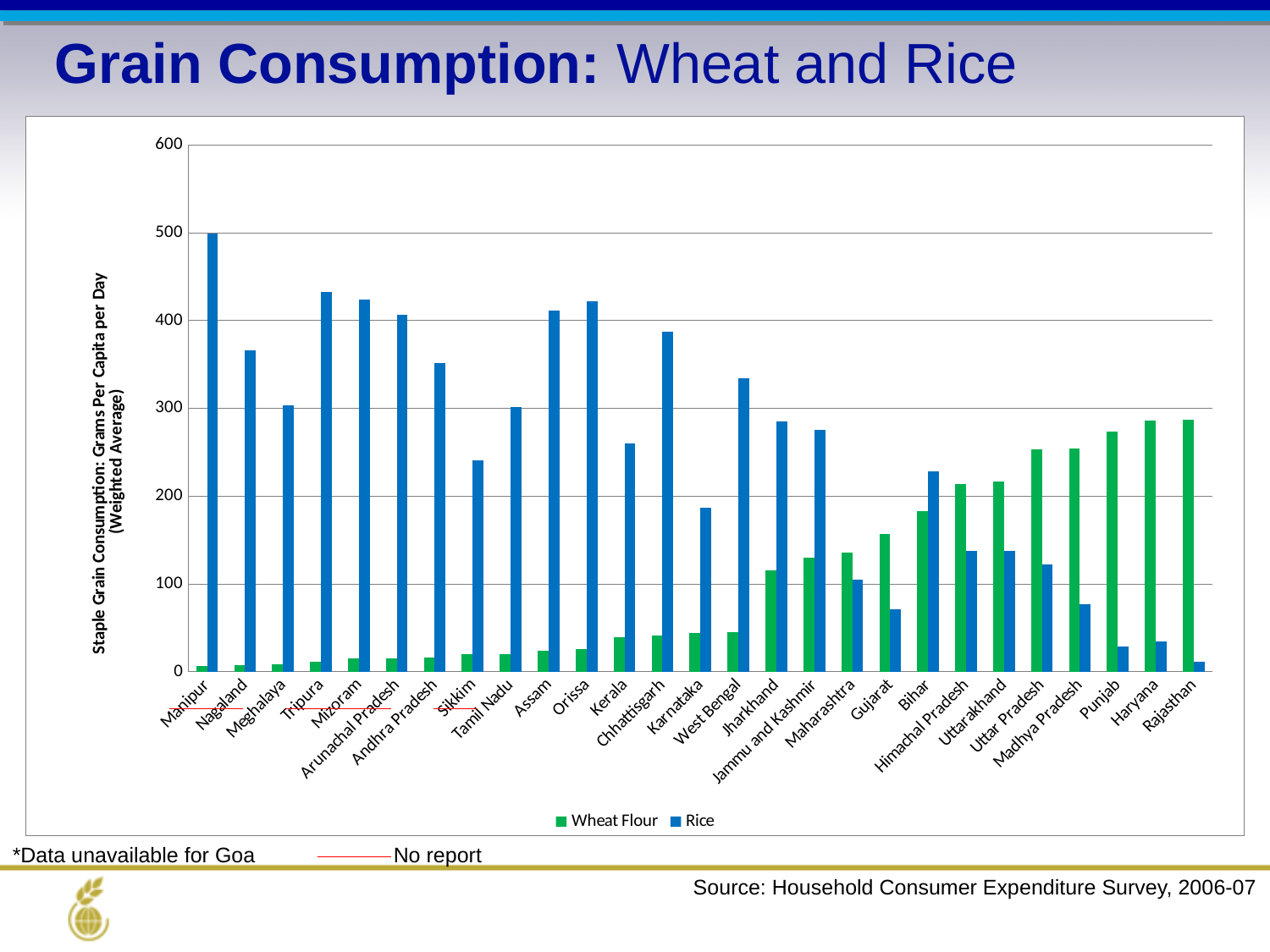
Which state has the lowest Rice consumption? Rajasthan What type of chart is shown on the slide? bar chart Is the Wheat Flour value for Punjab greater or less than 200? greater For Punjab, which is larger: Wheat Flour or Rice? Wheat Flour Do the Wheat Flour values generally rise or fall from left to right along the x axis? rise How many states are shown on the x axis? 27 Is the Rice value for Rajasthan greater or less than 100? less Which state has the highest Rice consumption? Manipur How many series does the legend list? 2 Is the Wheat Flour value for Gujarat greater or less than 100? greater For Kerala, which is larger: Wheat Flour or Rice? Rice